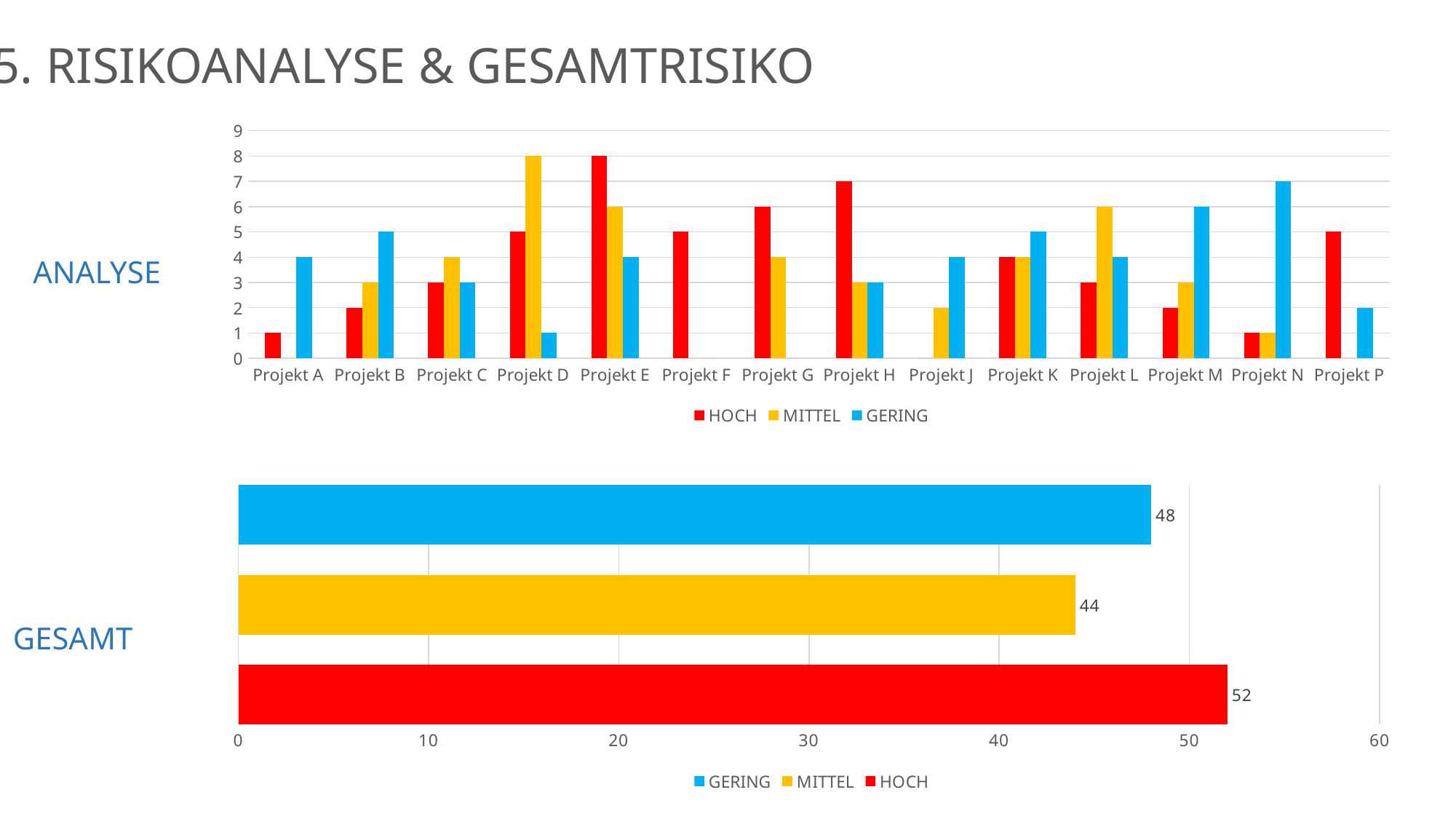
What kind of chart is the GESAMT chart at the bottom of the slide? bar chart In the ANALYSE chart at the top, what is the GERING value for Projekt N? 7 In the GESAMT chart at the bottom, is the value for GERING greater or less than 40? greater In the ANALYSE chart at the top, how many projects are shown on the x axis? 14 In the ANALYSE chart at the top, what is the MITTEL value for Projekt D? 8 In the GESAMT chart at the bottom, what is the difference between the HOCH and MITTEL values? 8 In the GESAMT chart at the bottom, what is the value for MITTEL? 44 In the ANALYSE chart at the top, how many series does the legend list? 3 In the GESAMT chart at the bottom, which category has the highest value? HOCH In the GESAMT chart at the bottom, what is the value for HOCH? 52 In the GESAMT chart at the bottom, which category has the lowest value? MITTEL In the ANALYSE chart at the top, which project has the highest HOCH value? Projekt E